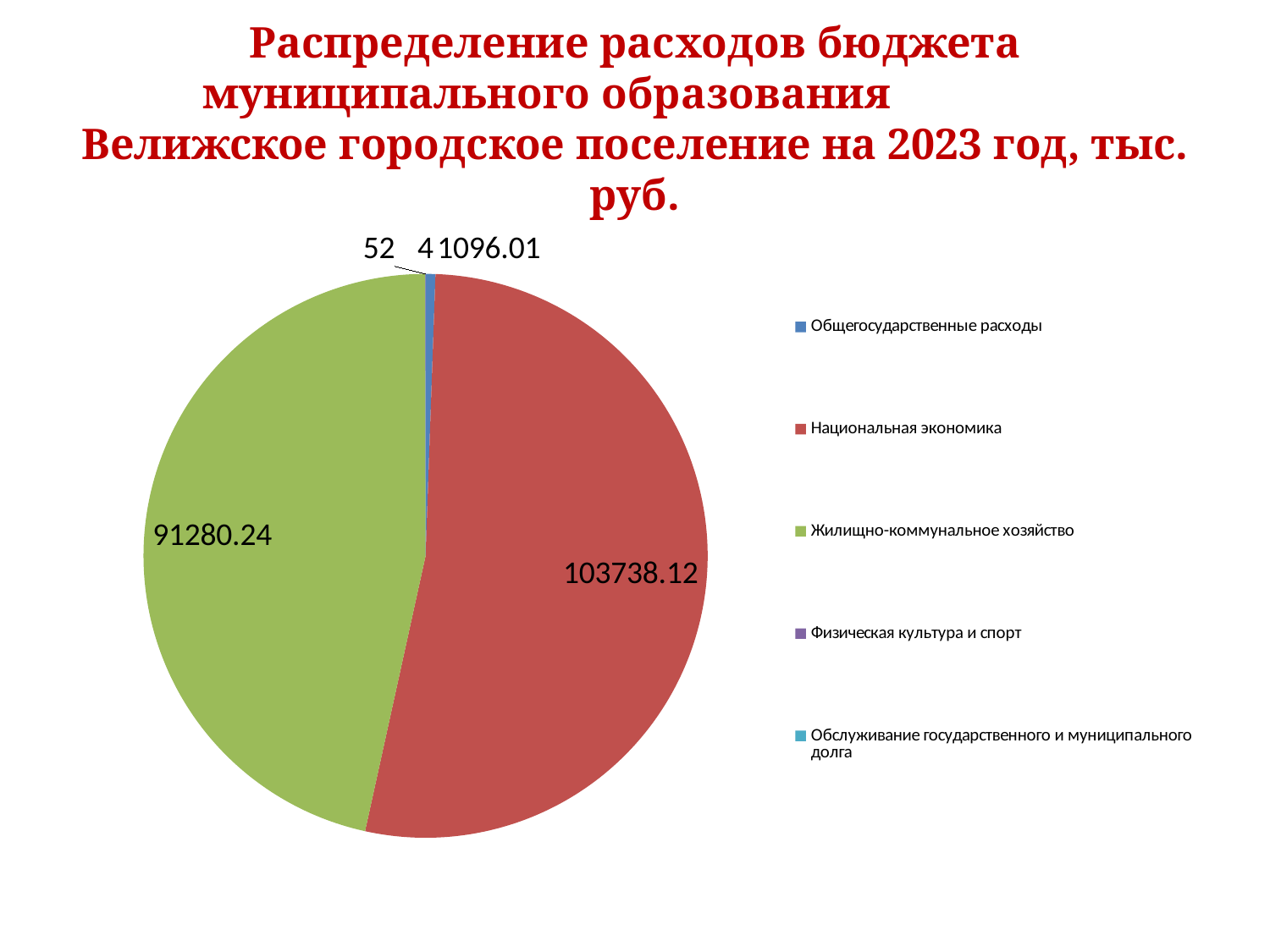
What is the value shown for Жилищно-коммунальное хозяйство? 91280.24 What is the value shown for Национальная экономика? 103738.12 What is the smallest data label value shown on the pie chart? 4 In what units are the values in the chart title expressed? тыс. руб. What colour is the slice for Жилищно-коммунальное хозяйство? Green Which category has the largest slice of the pie? Национальная экономика What is the value shown for Общегосударственные расходы? 1096.01 What kind of chart is shown on the slide? Pie chart What is the difference between the values for Национальная экономика and Жилищно-коммунальное хозяйство? 12457.88 How many categories does the legend of the pie chart list? 5 Which is larger, Национальная экономика or Жилищно-коммунальное хозяйство? Национальная экономика